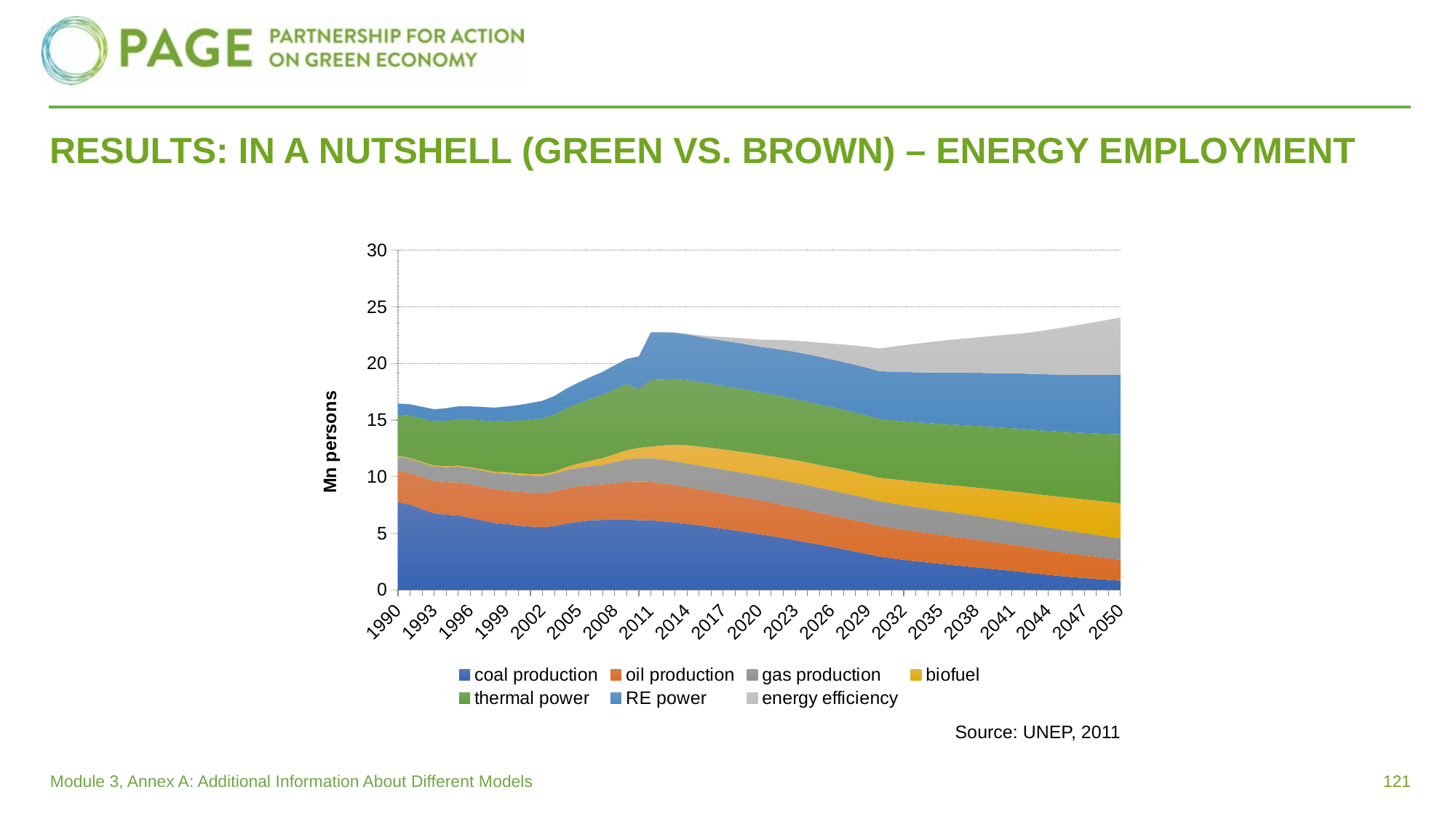
Does the energy efficiency area rise or fall from 2014 to 2050? Rises Is the total stacked value in 1990 greater or less than 20 Mn persons? less Does the coal production area rise or fall from 1990 to 2050? Falls Is the total stacked value in 2050 greater or less than 20 Mn persons? greater What is the label on the y axis? Mn persons How many year labels are shown along the x axis? 21 What kind of chart is shown on the slide? Stacked area chart Which series is plotted at the bottom of the stack? coal production How many series does the legend list? 7 Is the value for coal production in 2050 greater or less than 5 Mn persons? less Which is larger: the total stacked value in 2050 or in 1990? 2050